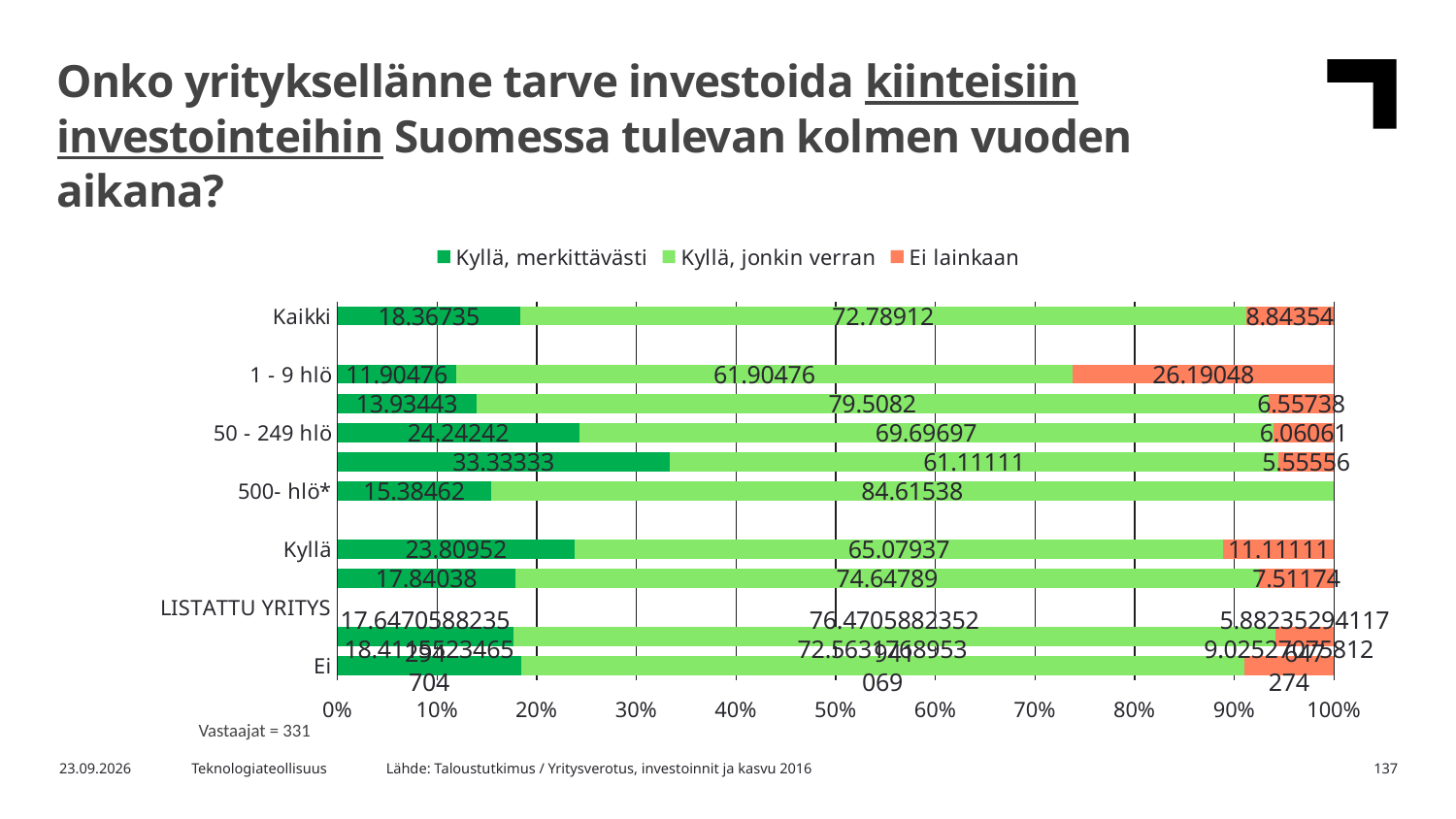
What is the value of "Kyllä, merkittävästi" for the category Kaikki? 18.36735 What kind of chart is shown on the slide? Stacked bar chart What is the value of "Kyllä, merkittävästi" for the category 50 - 249 hlö? 24.24242 Which has the larger "Ei lainkaan" value, 1 - 9 hlö or Kaikki? 1 - 9 hlö What is the difference between the "Kyllä, jonkin verran" values for Kaikki and 1 - 9 hlö? 10.88436 What is the value of "Ei lainkaan" for the category Kaikki? 8.84354 How many series does the legend list? 3 What is the value of "Ei lainkaan" for the category 1 - 9 hlö? 26.19048 What is the first entry in the chart legend? Kyllä, merkittävästi What is the value of "Kyllä, jonkin verran" for the category 500- hlö*? 84.61538 Which category has the highest "Ei lainkaan" value? 1 - 9 hlö What is the value of "Ei lainkaan" for the category Kyllä? 11.11111